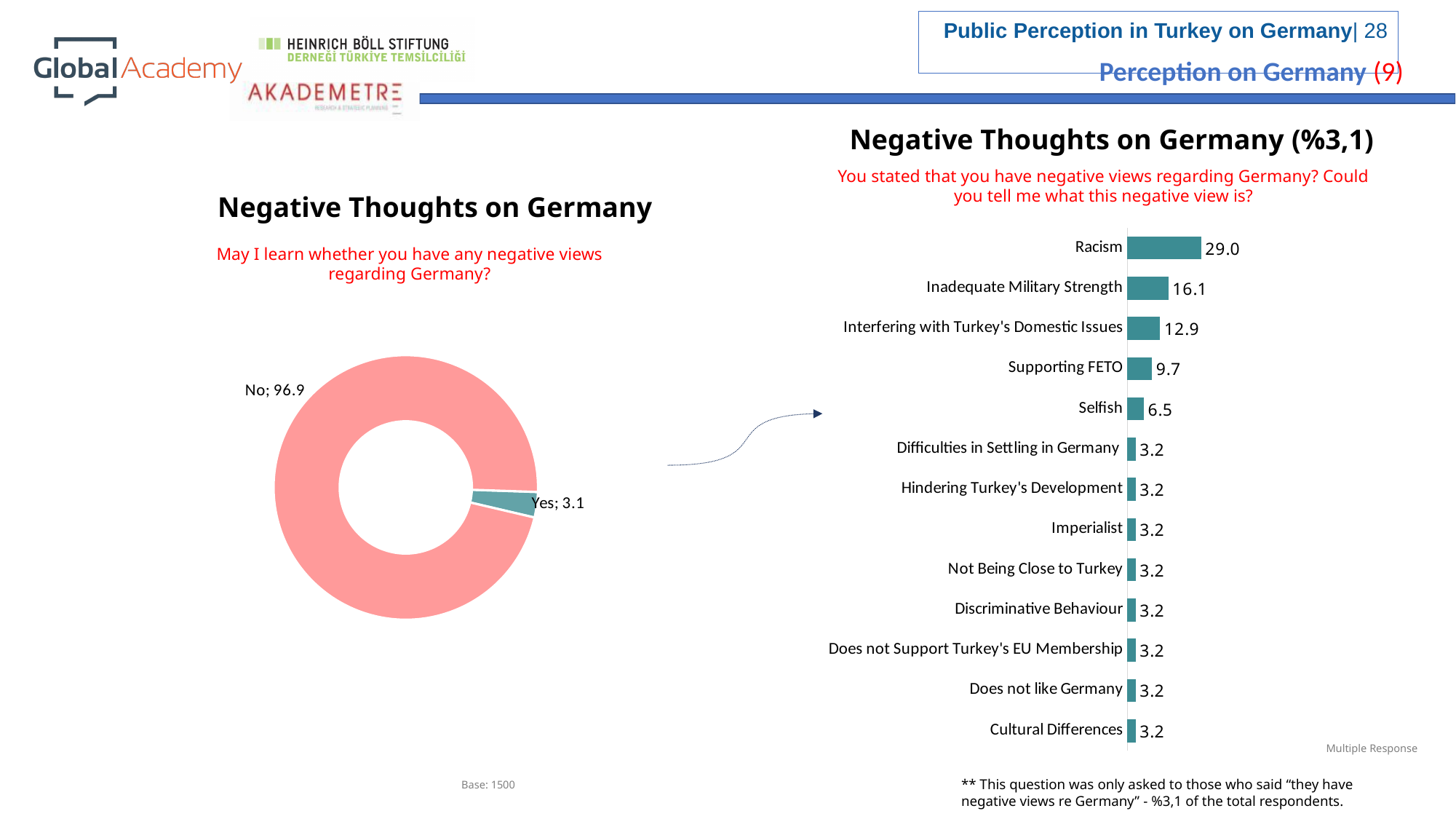
What kind of chart is the left chart on the slide? Pie (donut) chart In the right chart (Negative Thoughts on Germany (%3,1)), which category has the highest value? Racism In the left chart (Negative Thoughts on Germany donut), what is the value for "No"? 96.9 In the right chart (Negative Thoughts on Germany (%3,1)), what is the value for Supporting FETO? 9.7 In the left chart (Negative Thoughts on Germany donut), what is the value for "Yes"? 3.1 In the right chart (Negative Thoughts on Germany (%3,1)), what is the difference between Racism and Inadequate Military Strength? 12.9 In the right chart (Negative Thoughts on Germany (%3,1)), which is larger: Interfering with Turkey's Domestic Issues or Selfish? Interfering with Turkey's Domestic Issues In the right chart (Negative Thoughts on Germany (%3,1)), what is the value for Selfish? 6.5 In the right chart (Negative Thoughts on Germany (%3,1)), how many categories are shown? 13 What kind of chart is the right chart on the slide? Bar chart In the left donut chart, how many slices are there? 2 In the right chart (Negative Thoughts on Germany (%3,1)), what is the value for Racism? 29.0